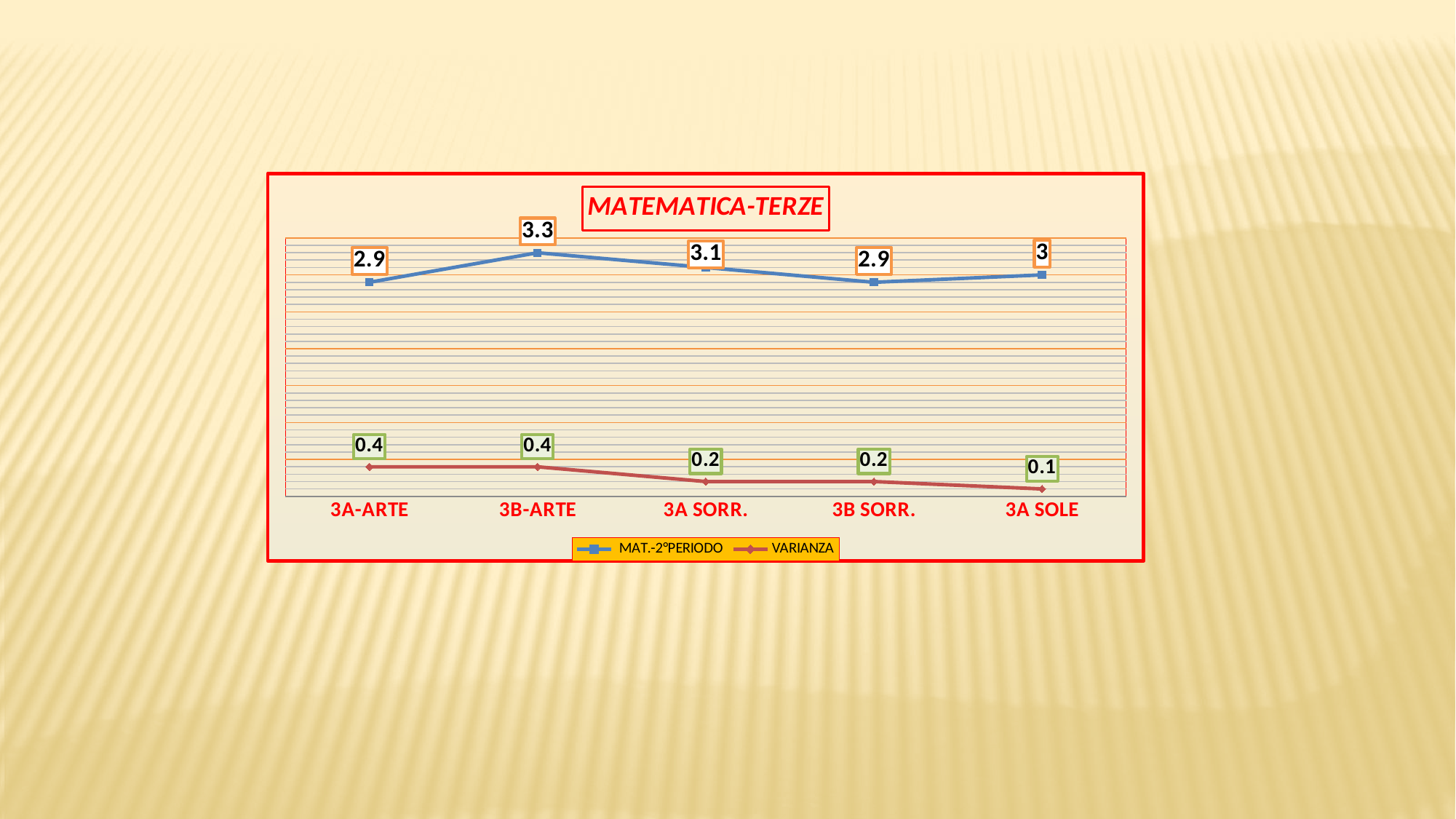
Which category has the lowest VARIANZA value? 3A SOLE What is the title of the chart? MATEMATICA-TERZE What is the VARIANZA value for 3A SOLE? 0.1 What is the difference between the MAT.-2°PERIODO values for 3B-ARTE and 3A-ARTE? 0.4 What kind of chart is shown? line chart How many series does the legend list? 2 What is the MAT.-2°PERIODO value for 3B-ARTE? 3.3 How many categories are shown on the x axis? 5 What is the VARIANZA value for 3B SORR.? 0.2 What is the MAT.-2°PERIODO value for 3A SORR.? 3.1 Which category has the highest MAT.-2°PERIODO value? 3B-ARTE Which is larger, the MAT.-2°PERIODO value for 3A SORR. or for 3A SOLE? 3A SORR.